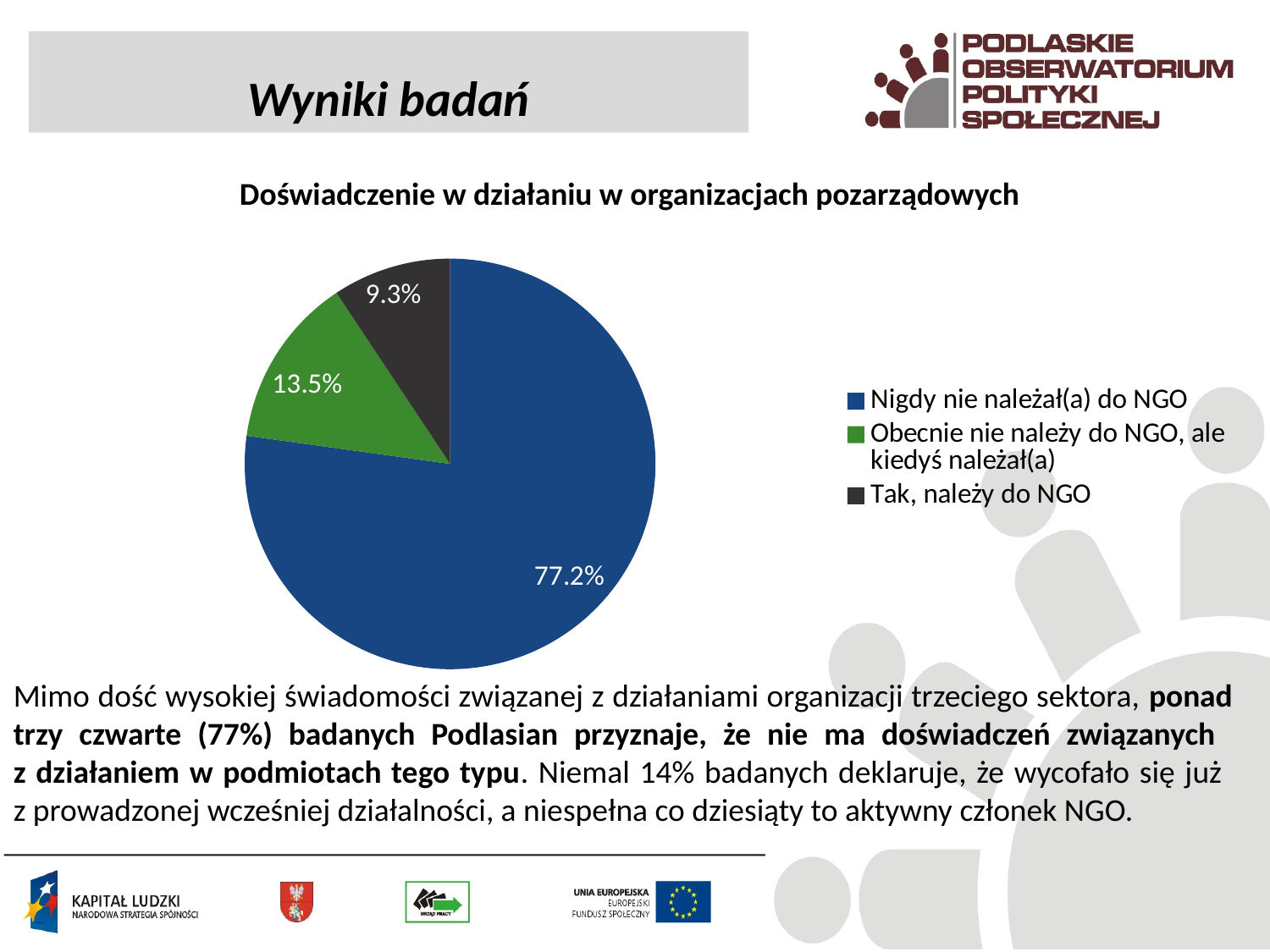
What is the title of the chart? Doświadczenie w działaniu w organizacjach pozarządowych What is the value for "Obecnie nie należy do NGO, ale kiedyś należał(a)"? 13.5% What is the difference between the shares for "Nigdy nie należał(a) do NGO" and "Obecnie nie należy do NGO, ale kiedyś należał(a)"? 63.7% How many categories does the pie chart have? 3 Which category has the largest share of the pie? Nigdy nie należał(a) do NGO What is the difference between the shares for "Obecnie nie należy do NGO, ale kiedyś należał(a)" and "Tak, należy do NGO"? 4.2% Which is larger: the share for "Obecnie nie należy do NGO, ale kiedyś należał(a)" or the share for "Tak, należy do NGO"? Obecnie nie należy do NGO, ale kiedyś należał(a) What kind of chart is shown on the slide? pie chart Which category has the smallest share of the pie? Tak, należy do NGO What is the value for "Nigdy nie należał(a) do NGO"? 77.2% What colour is the slice for "Tak, należy do NGO"? dark grey What is the value for "Tak, należy do NGO"? 9.3%